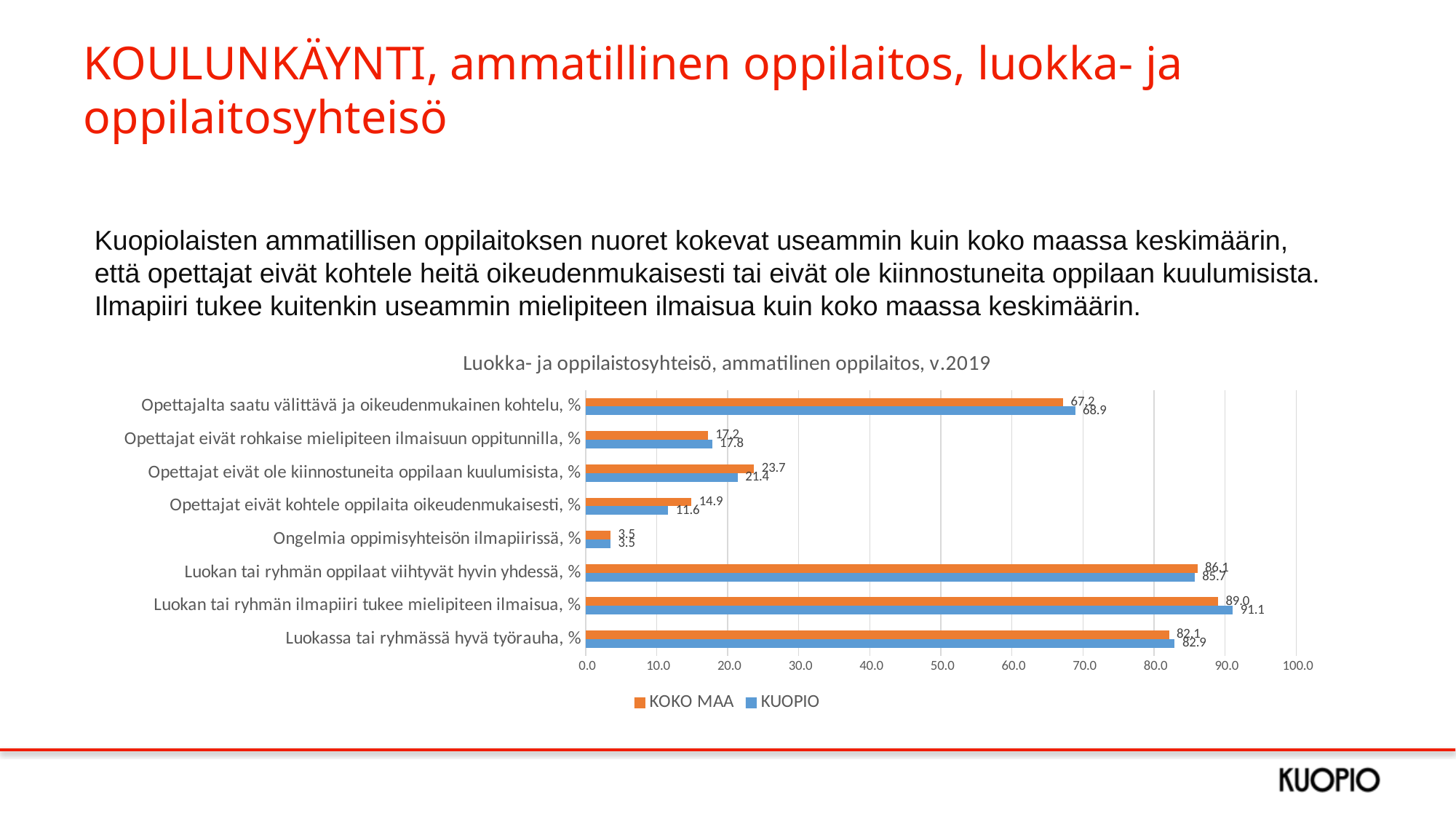
How many series does the legend list? 2 What kind of chart is shown on the slide? Bar chart For "Opettajat eivät ole kiinnostuneita oppilaan kuulumisista, %", which series has the larger value, KOKO MAA or KUOPIO? KOKO MAA What is the KUOPIO value for "Luokan tai ryhmän ilmapiiri tukee mielipiteen ilmaisua, %"? 91.1 Which category has the lowest KOKO MAA value? Ongelmia oppimisyhteisön ilmapiirissä, % What is the KOKO MAA value for "Luokassa tai ryhmässä hyvä työrauha, %"? 82.1 Which category has the highest KUOPIO value? Luokan tai ryhmän ilmapiiri tukee mielipiteen ilmaisua, % Is the KUOPIO value for "Luokan tai ryhmän oppilaat viihtyvät hyvin yhdessä, %" greater or less than 80.0? greater What is the KUOPIO value for "Opettajalta saatu välittävä ja oikeudenmukainen kohtelu, %"? 68.9 What is the difference between the KOKO MAA and KUOPIO values for "Opettajat eivät kohtele oppilaita oikeudenmukaisesti, %"? 3.3 How many categories are shown on the chart? 8 What is the KOKO MAA value for "Opettajat eivät ole kiinnostuneita oppilaan kuulumisista, %"? 23.7